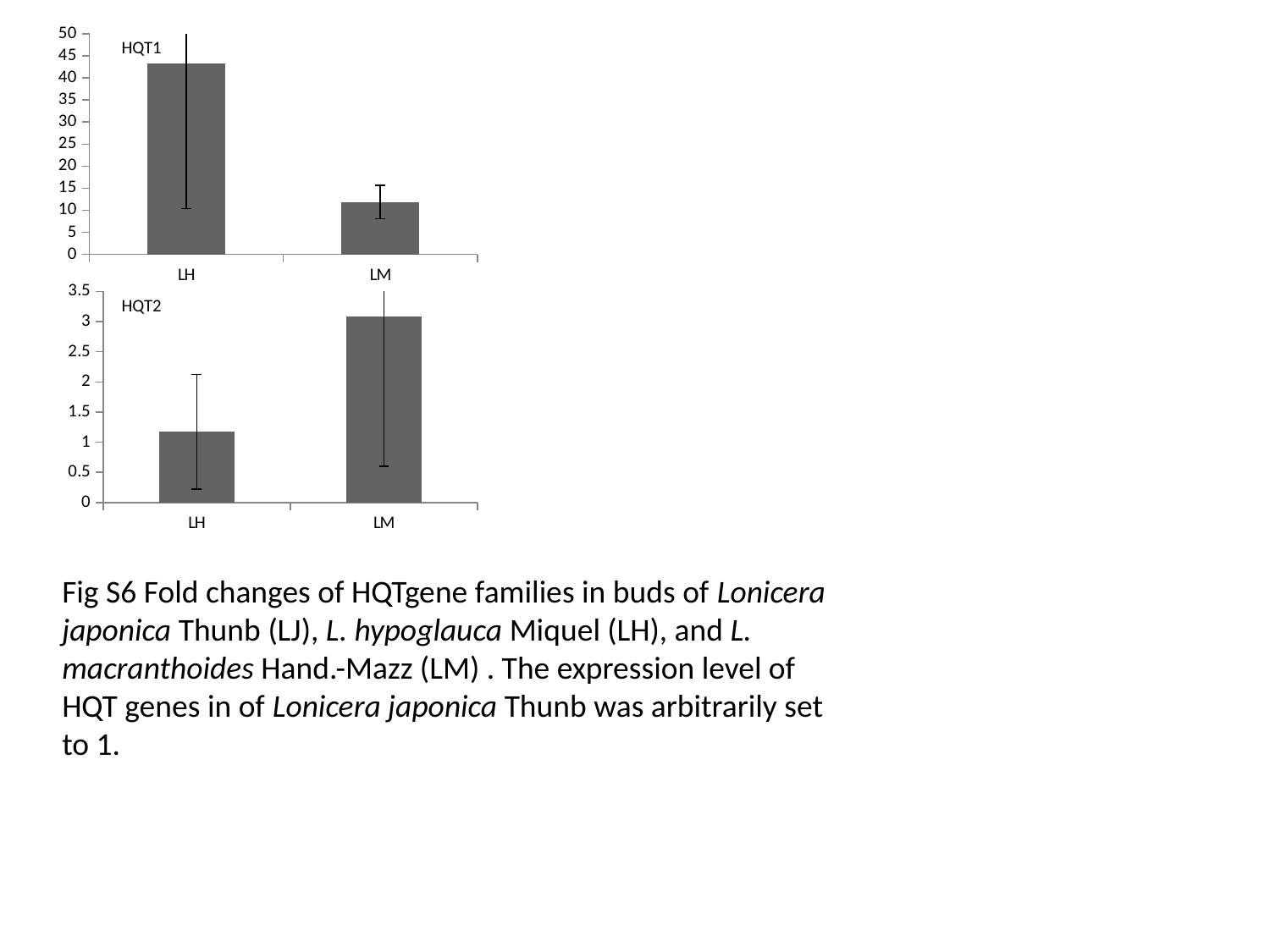
In the HQT1 chart (top), which category has the highest value? LH In the HQT1 chart (top), which is larger, the value for LH or the value for LM? LH What kind of chart is the HQT2 chart (bottom)? bar chart In the HQT2 chart (bottom), which category has the lowest value? LH In the HQT2 chart (bottom), is the value for LH greater or less than 1.5? less How many categories are shown in the HQT1 chart (top)? 2 In the HQT1 chart (top), which category has the lowest value? LM In the HQT2 chart (bottom), which is larger, the value for LH or the value for LM? LM In the HQT1 chart (top), is the value for LH greater or less than 40? greater In the HQT2 chart (bottom), is the value for LM greater or less than 2.5? greater In the HQT2 chart (bottom), which category has the highest value? LM